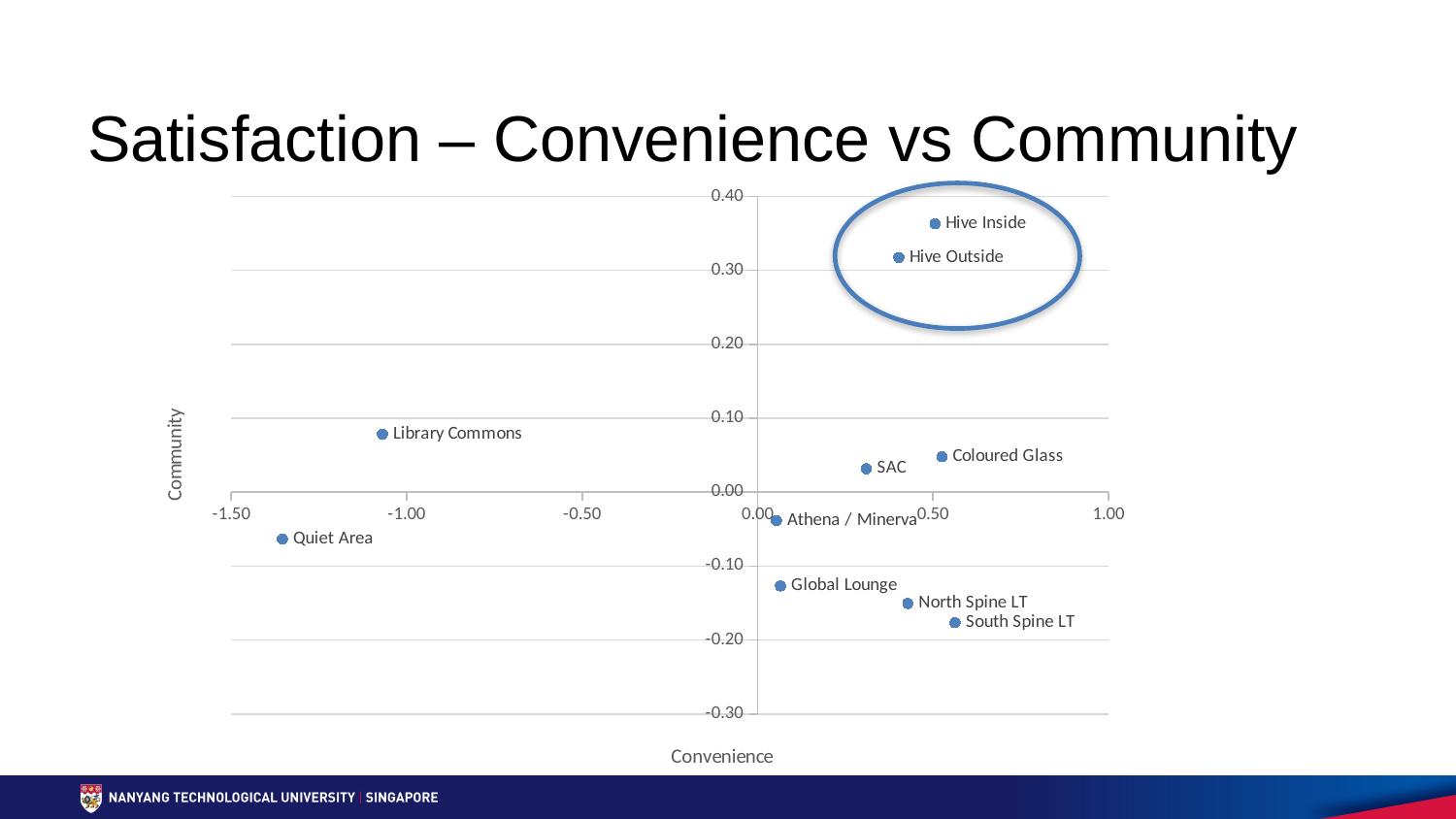
Which has the higher Community value, Hive Inside or Hive Outside? Hive Inside Which location has the lowest Convenience value? Quiet Area Which has the higher Convenience value, Quiet Area or Library Commons? Library Commons Is the Convenience value for Library Commons greater or less than -0.50? less What kind of chart is shown on the slide? Scatter chart Is the Community value for Hive Inside greater or less than 0.30? greater How many labelled points are plotted on the chart? 10 Which location has the highest Community value? Hive Inside Is the Community value for South Spine LT greater or less than -0.10? less Which location has the lowest Community value? South Spine LT What is the label of the vertical axis? Community